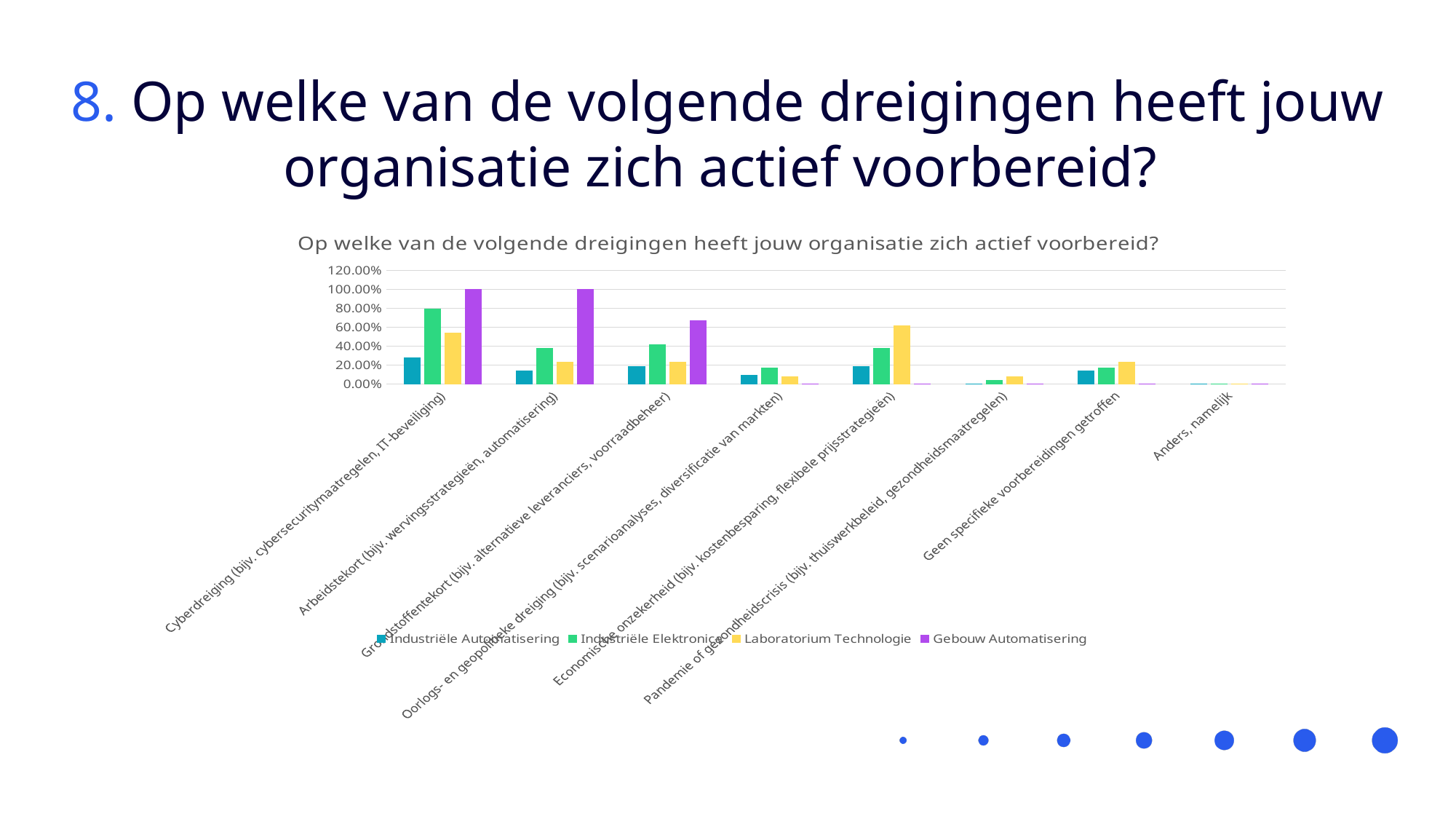
How many categories are shown on the x axis? 8 Which series has the highest value in the Economische onzekerheid category? Laboratorium Technologie Is the value for Laboratorium Technologie in the Economische onzekerheid category greater or less than 40.00%? greater How many series does the legend list? 4 What kind of chart is shown on the slide? bar chart Is the value for Industriële Elektronica in the Cyberdreiging category greater or less than 60.00%? greater In the Cyberdreiging category, which is larger: Industriële Elektronica or Laboratorium Technologie? Industriële Elektronica Is the value for Industriële Automatisering in the Cyberdreiging category greater or less than 40.00%? less Which colour represents Gebouw Automatisering in the legend? purple What is the value for Gebouw Automatisering in the Cyberdreiging category? 100.00% In the Grondstoffentekort category, which is larger: Gebouw Automatisering or Industriële Elektronica? Gebouw Automatisering What is the value for Gebouw Automatisering in the Arbeidstekort category? 100.00%